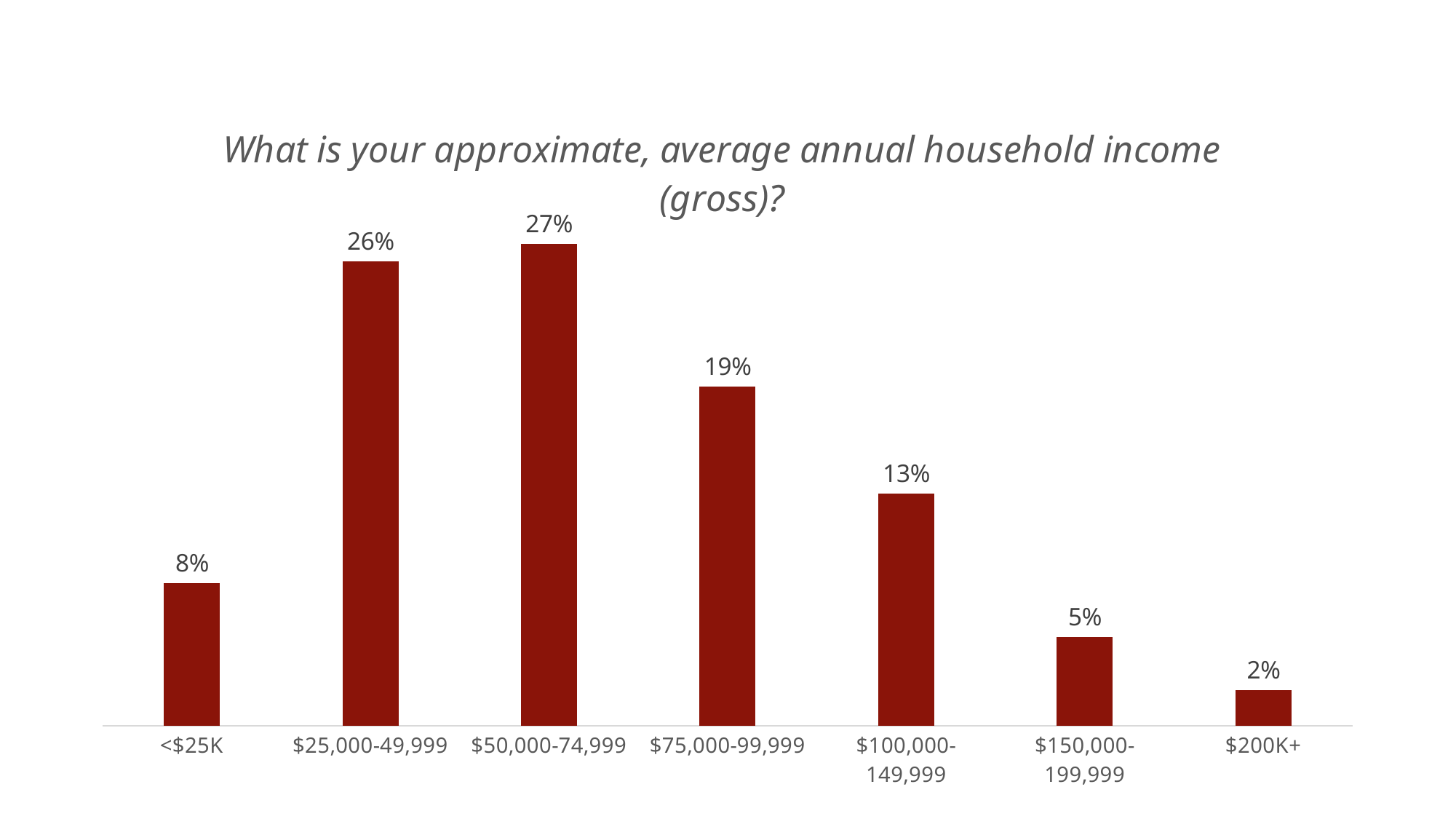
What percentage of respondents reported a household income of $50,000-74,999? 27% What is the difference between the $150,000-199,999 and $200K+ values? 3% What is the title of the chart? What is your approximate, average annual household income (gross)? What is the value shown for the <$25K category? 8% Which is larger, the value for <$25K or the value for $150,000-199,999? <$25K Which income bracket has the highest percentage? $50,000-74,999 What kind of chart is shown on the slide? Bar chart Do the values rise or fall from $50,000-74,999 to $200K+ along the x axis? Fall What is the difference between the $25,000-49,999 and $75,000-99,999 percentages? 7% How many income brackets are shown on the chart? 7 Which income bracket has the lowest percentage? $200K+ What percentage is shown for the $100,000-149,999 income bracket? 13%